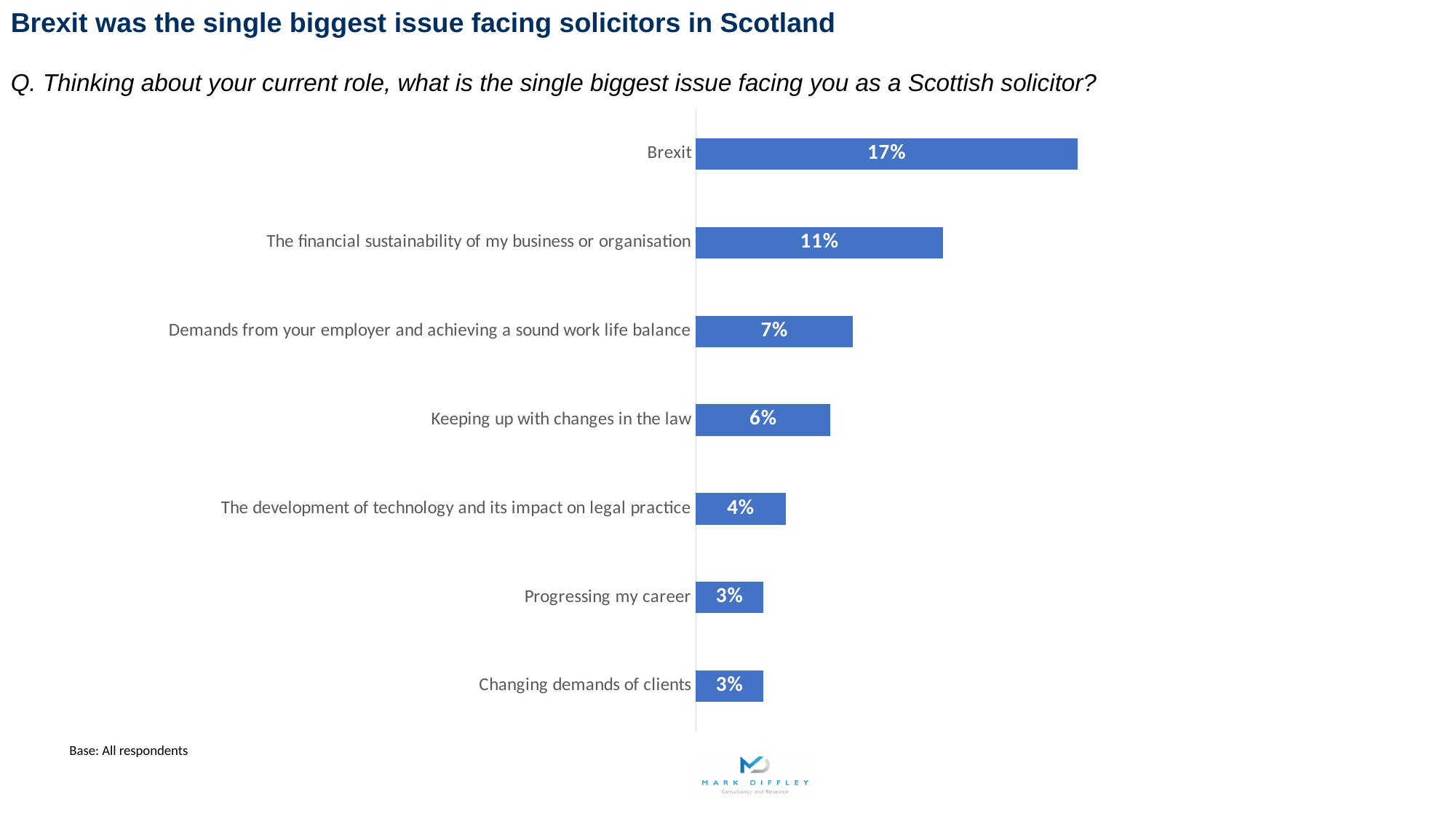
Which issue has the highest percentage in the chart? Brexit How many issues (categories) are shown in the chart? 7 What is the difference in percentage points between 'Demands from your employer and achieving a sound work life balance' and 'Progressing my career'? 4 What percentage of respondents said Brexit was the single biggest issue facing them? 17% Which has a larger value: 'Keeping up with changes in the law' or 'The development of technology and its impact on legal practice'? Keeping up with changes in the law Which two issues share the same value of 3%? Progressing my career; Changing demands of clients What value is shown for 'The financial sustainability of my business or organisation'? 11% What percentage is shown for 'Keeping up with changes in the law'? 6% What kind of chart is shown on the slide? Bar chart What is the base stated for the chart? All respondents What is the difference in percentage points between Brexit and 'The financial sustainability of my business or organisation'? 6 What value is shown for 'The development of technology and its impact on legal practice'? 4%